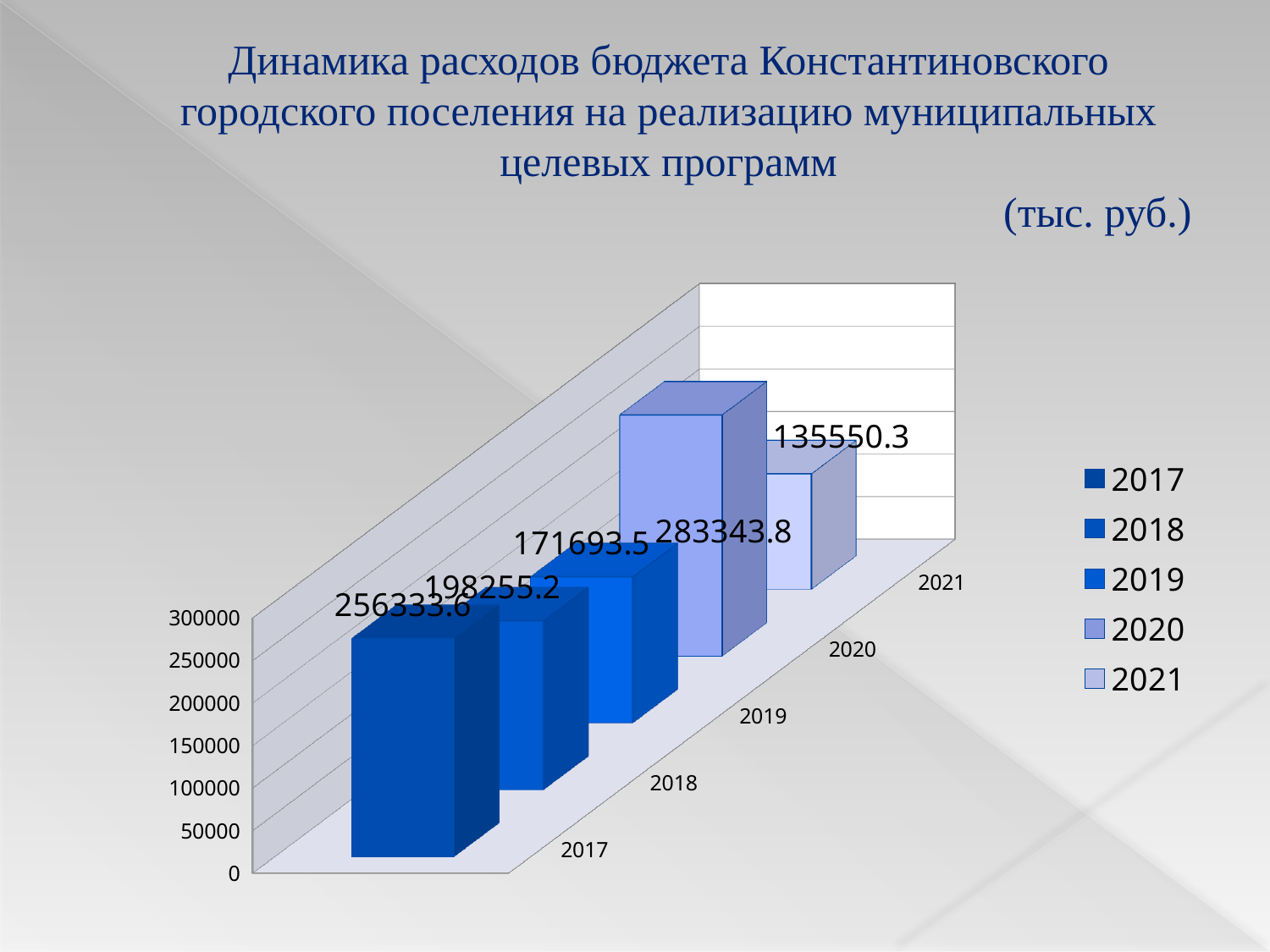
What is the difference between the values for 2020 and 2017? 27010.2 What is the difference between the values for 2018 and 2019? 26561.7 Is the value for 2021 greater or less than 150000? less What is the value for 2020? 283343.8 How many years are shown on the chart? 5 Which is larger, the value for 2018 or the value for 2019? 2018 Which year has the highest value? 2020 Which year has the lowest value? 2021 What kind of chart is shown on the slide? bar chart What is the value for 2017? 256333.6 What is the value for 2021? 135550.3 What is the value for 2019? 171693.5